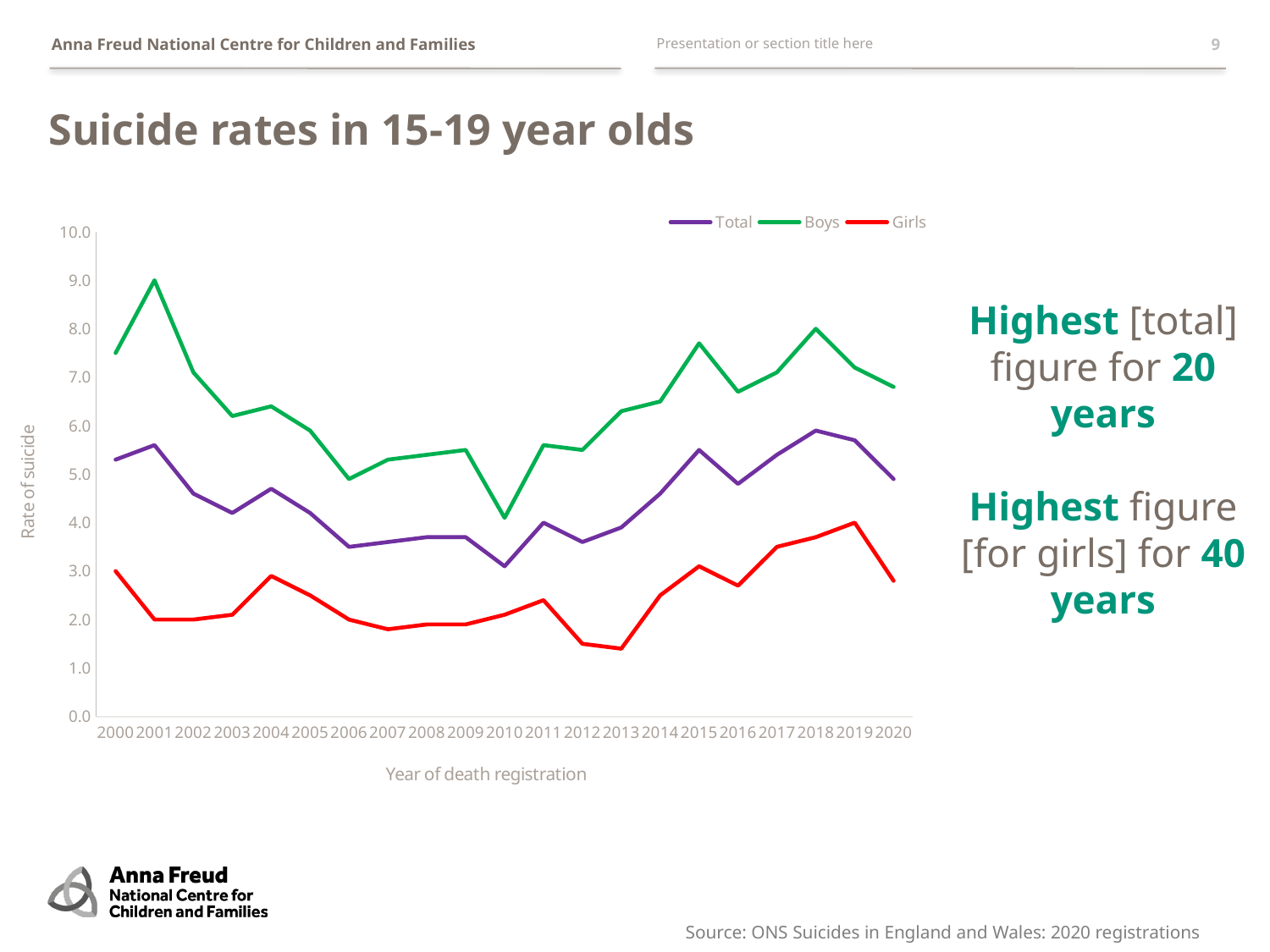
Does the Girls series rise or fall between 2013 and 2019? Rise Is the value for Girls in 2013 greater or less than 2.0? less How many years are plotted along the x axis? 21 In which year is the Girls series at its highest? 2019 Is the value for Total in 2010 greater or less than 4.0? less In which year is the Boys series at its lowest? 2010 How many series does the legend list? 3 Which series has the higher value in 2000, Boys or Girls? Boys What kind of chart is shown on the slide? Line chart In which year is the Total series at its lowest? 2010 Is the value for Boys in 2001 greater or less than 8.0? greater In which year is the Boys series at its highest? 2001